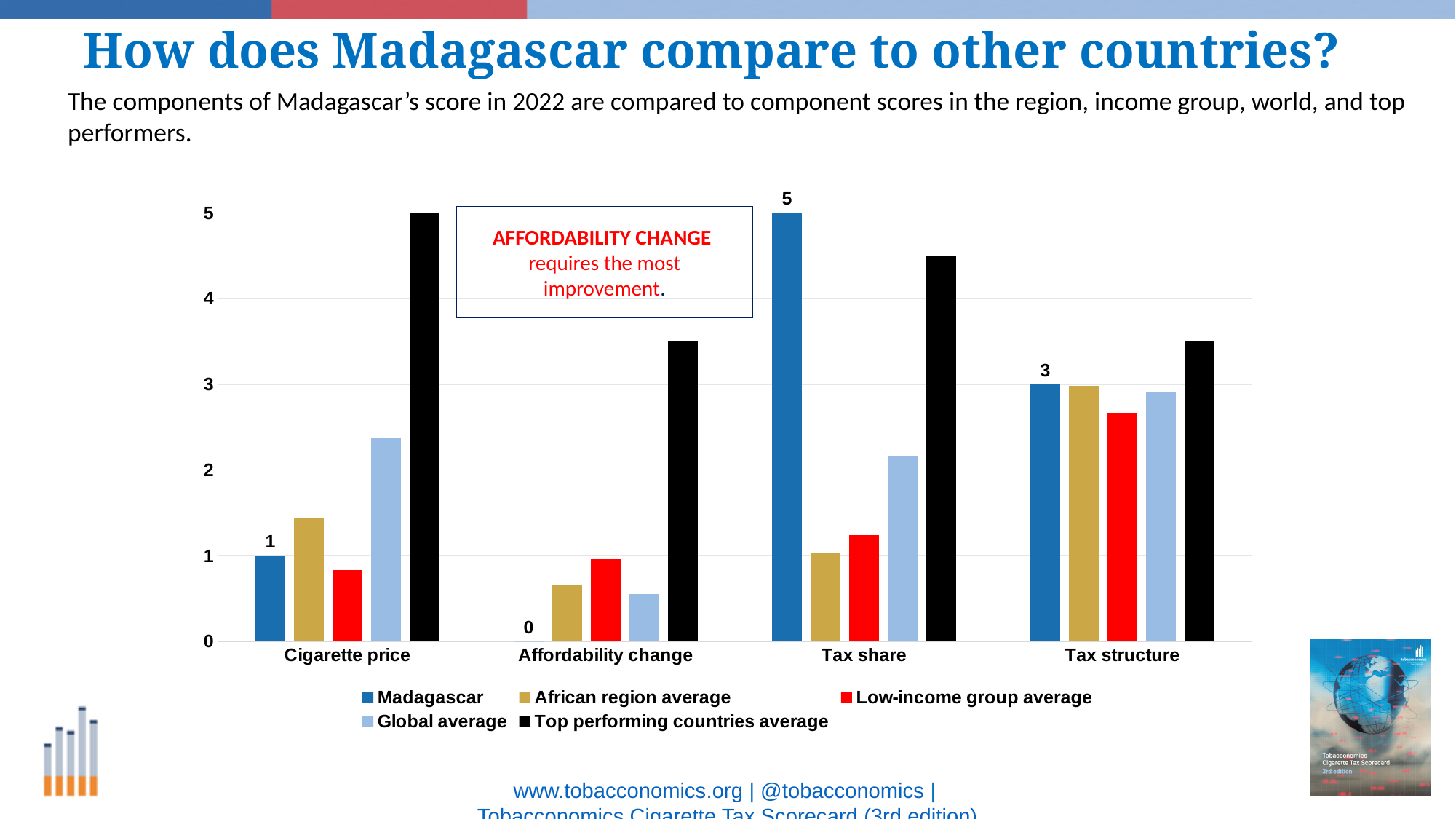
What is Madagascar's score for Affordability change? 0 What type of chart is shown on the slide? Bar chart Is the Top performing countries average for Affordability change greater or less than 3? greater What is the difference between Madagascar's Tax share score and its Cigarette price score? 4 Is the Global average for Cigarette price greater or less than 2? greater How many series does the legend list? 5 What is Madagascar's score for Cigarette price? 1 In which component does Madagascar have its highest score? Tax share For Tax share, which is larger: Madagascar or the Global average? Madagascar What is Madagascar's score for Tax share? 5 What is Madagascar's score for Tax structure? 3 In which component does Madagascar have its lowest score? Affordability change